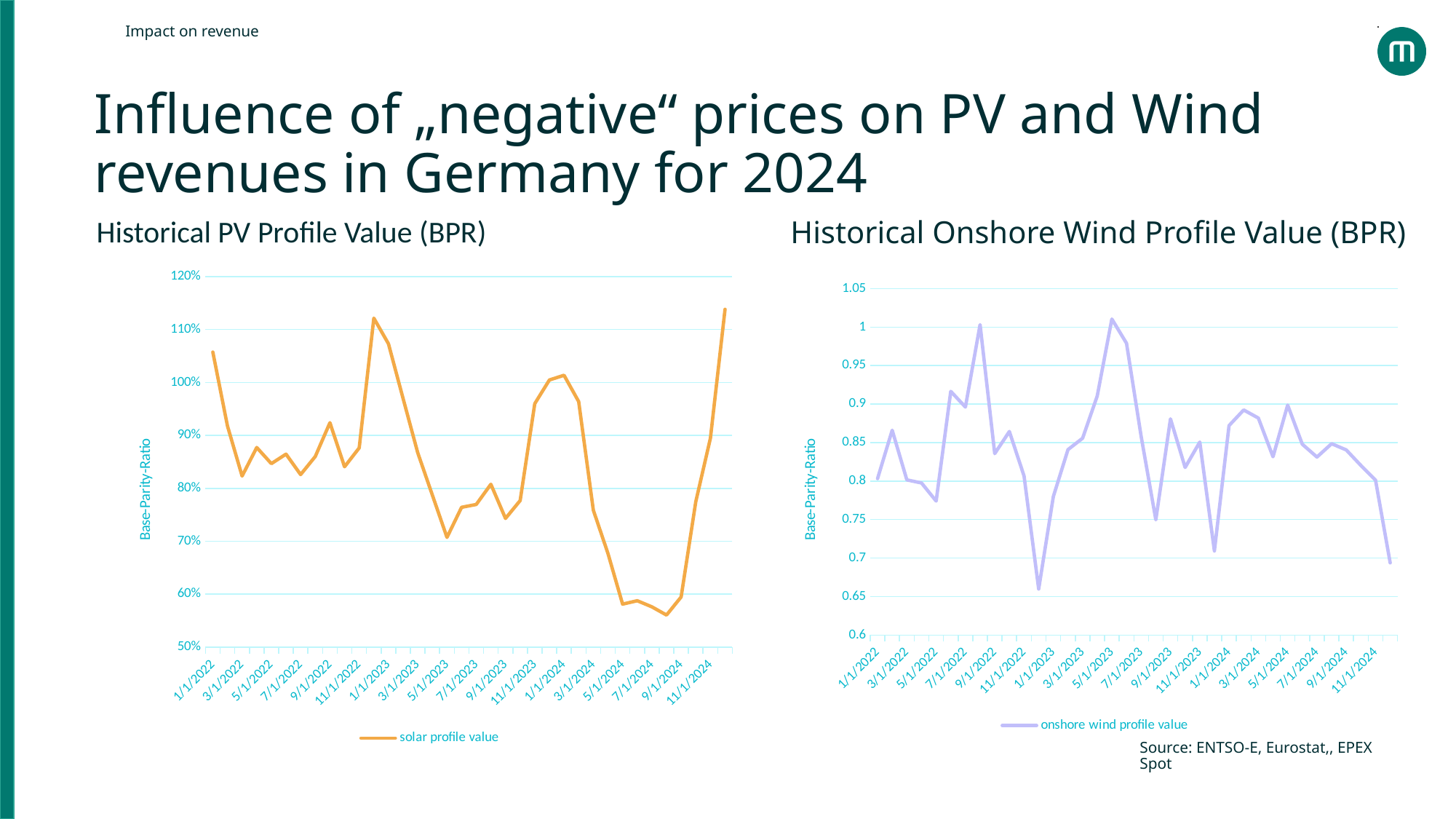
In the Historical Onshore Wind Profile Value (BPR) chart, is the value for 1/1/2023 greater or less than 0.7? greater In the Historical PV Profile Value (BPR) chart, is the value for 5/1/2023 greater or less than 80%? less What kind of chart is the Historical PV Profile Value (BPR) chart? line chart In the Historical Onshore Wind Profile Value (BPR) chart, is the value for 11/1/2024 greater or less than 0.75? greater What is the y-axis label of the Historical Onshore Wind Profile Value (BPR) chart? Base-Parity-Ratio In the Historical Onshore Wind Profile Value (BPR) chart, does the onshore wind profile value rise or fall between 5/1/2023 and 9/1/2023? fall In the Historical PV Profile Value (BPR) chart, does the solar profile value rise or fall between 1/1/2024 and 7/1/2024? fall What is the legend entry of the Historical PV Profile Value (BPR) chart? solar profile value How many series does the legend of the Historical Onshore Wind Profile Value (BPR) chart list? 1